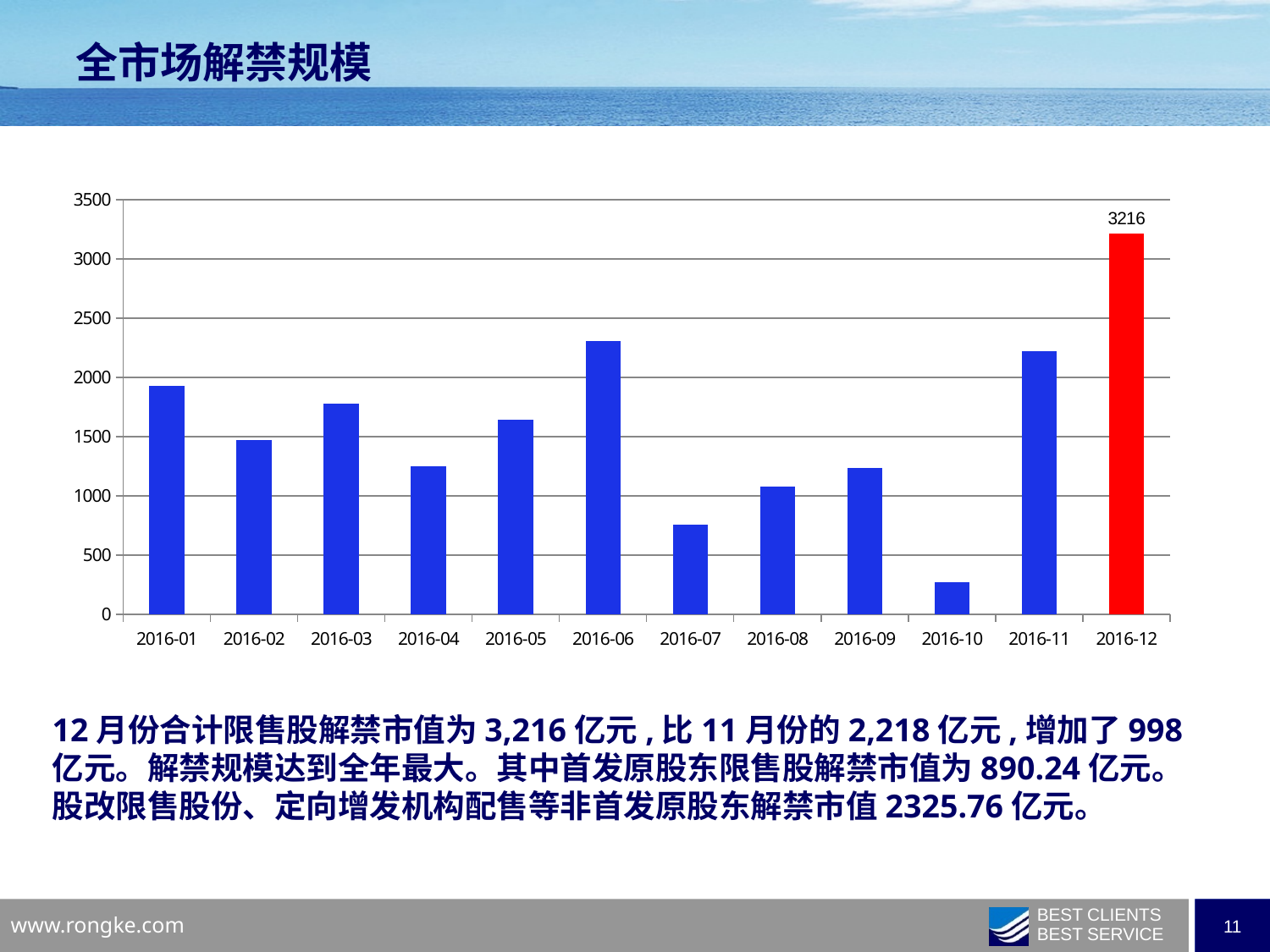
Which month has the highest value? 2016-12 Is the value for 2016-01 greater or less than 1500? greater What kind of chart is shown on the slide? bar chart Which bar is coloured red instead of blue? 2016-12 Is the value for 2016-06 greater or less than 2000? greater Is the value for 2016-10 greater or less than 500? less Which is larger, the value for 2016-01 or 2016-02? 2016-01 Which month has the lowest value? 2016-10 How many months are shown on the x axis? 12 What is the value shown for 2016-12? 3216